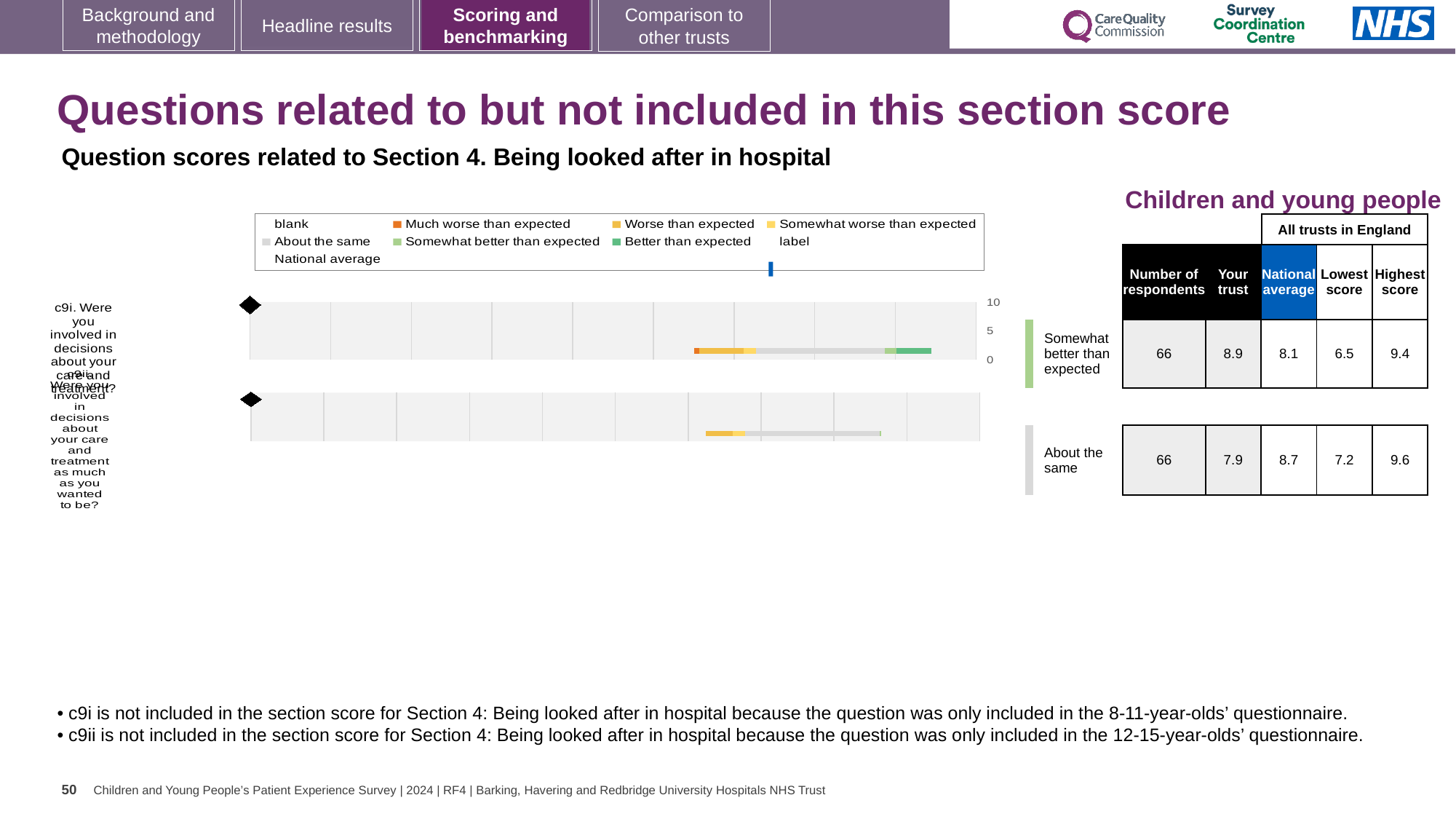
How many entries does the chart legend list? 9 How many questions (categories) are plotted in the chart area? 2 Which question's trust score falls in the 'Somewhat better than expected' band? c9i What is the 'Your trust' score for question c9i? 8.9 What is the 'Your trust' score for question c9ii? 7.9 Which question has the higher 'Your trust' score, c9i or c9ii? c9i What kind of chart is used to show the question scores for c9i and c9ii? bar chart What colour does the legend use for 'Better than expected'? green Which question's trust score falls in the 'About the same' band? c9ii What colour does the legend use for 'Much worse than expected'? orange What is the national average score for question c9ii? 8.7 What is the difference between the highest score and the lowest score for question c9i? 2.9